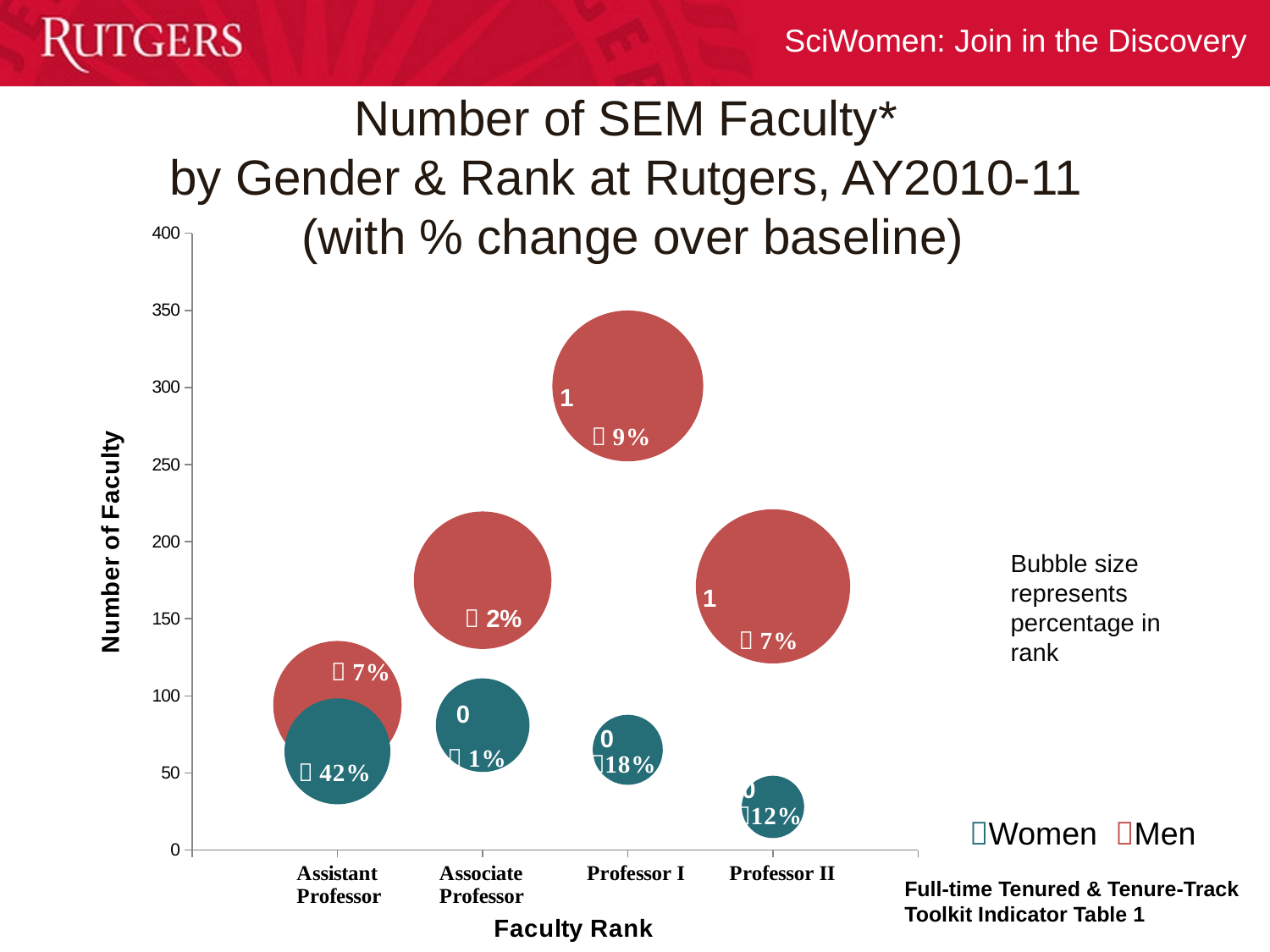
Which rank and gender has the highest number of faculty? Men, Professor I Is the number of Women at the Assistant Professor rank greater or less than 100? less Is the number of Men at the Associate Professor rank greater or less than 150? greater Which rank and gender has the lowest number of faculty? Women, Professor II What percentage change is labeled on the Women Assistant Professor bubble? 42% How many faculty ranks are shown along the x axis? 4 Is the number of Men at the Professor I rank greater or less than 250? greater How many series does the legend list? 2 At the Professor I rank, which group has more faculty, Women or Men? Men What kind of chart is shown on the slide? bubble chart According to the note on the slide, what does bubble size represent? percentage in rank